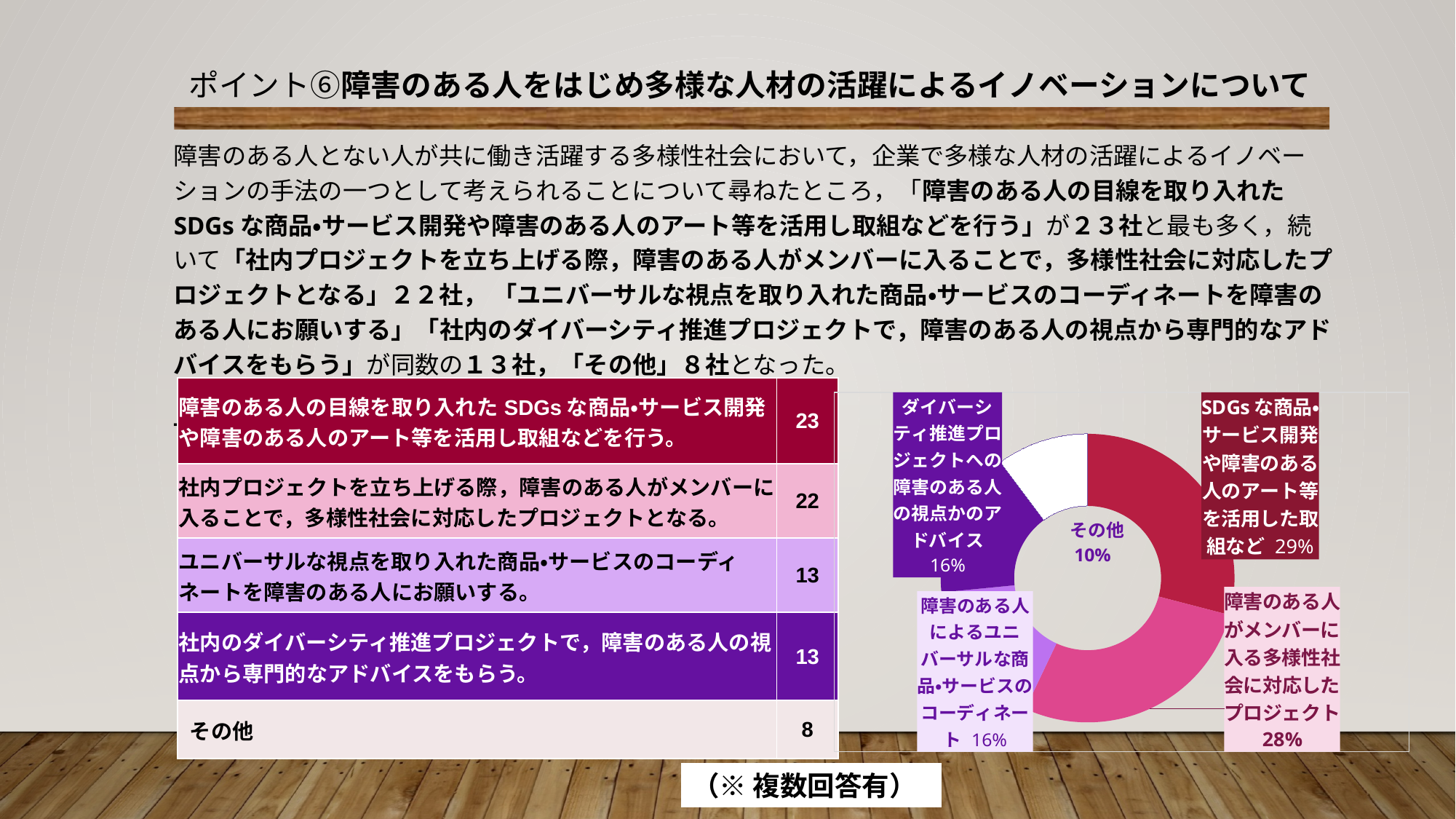
Which slice of the doughnut chart has the smallest share? その他 (10%) In the doughnut chart, what share is shown for the slice labelled 「SDGs な商品•サービス開発や障害のある人のアート等を活用した取組など」? 29% Which slice of the doughnut chart has the largest share? SDGs な商品•サービス開発や障害のある人のアート等を活用した取組など (29%) What kind of chart is shown on the right side of the slide? Doughnut chart In the doughnut chart, what share is shown for the slice labelled 「障害のある人によるユニバーサルな商品•サービスのコーディネート」? 16% In the doughnut chart, what share is shown for the slice labelled 「障害のある人がメンバーに入る多様性社会に対応したプロジェクト」? 28% What colour is the 「その他」 slice in the doughnut chart? White In the doughnut chart, what is the difference in percentage points between the 「SDGs な商品•サービス開発…」 slice (29%) and the 「その他」 slice (10%)? 19 percentage points How many slices does the doughnut chart have? 5 In the doughnut chart, what share is shown for 「その他」? 10% In the doughnut chart, what share is shown for the slice labelled 「ダイバーシティ推進プロジェクトへの障害のある人の視点かのアドバイス」? 16% In the doughnut chart, which is larger: the share for 「障害のある人がメンバーに入る多様性社会に対応したプロジェクト」 or the share for 「障害のある人によるユニバーサルな商品•サービスのコーディネート」? 障害のある人がメンバーに入る多様性社会に対応したプロジェクト (28%)